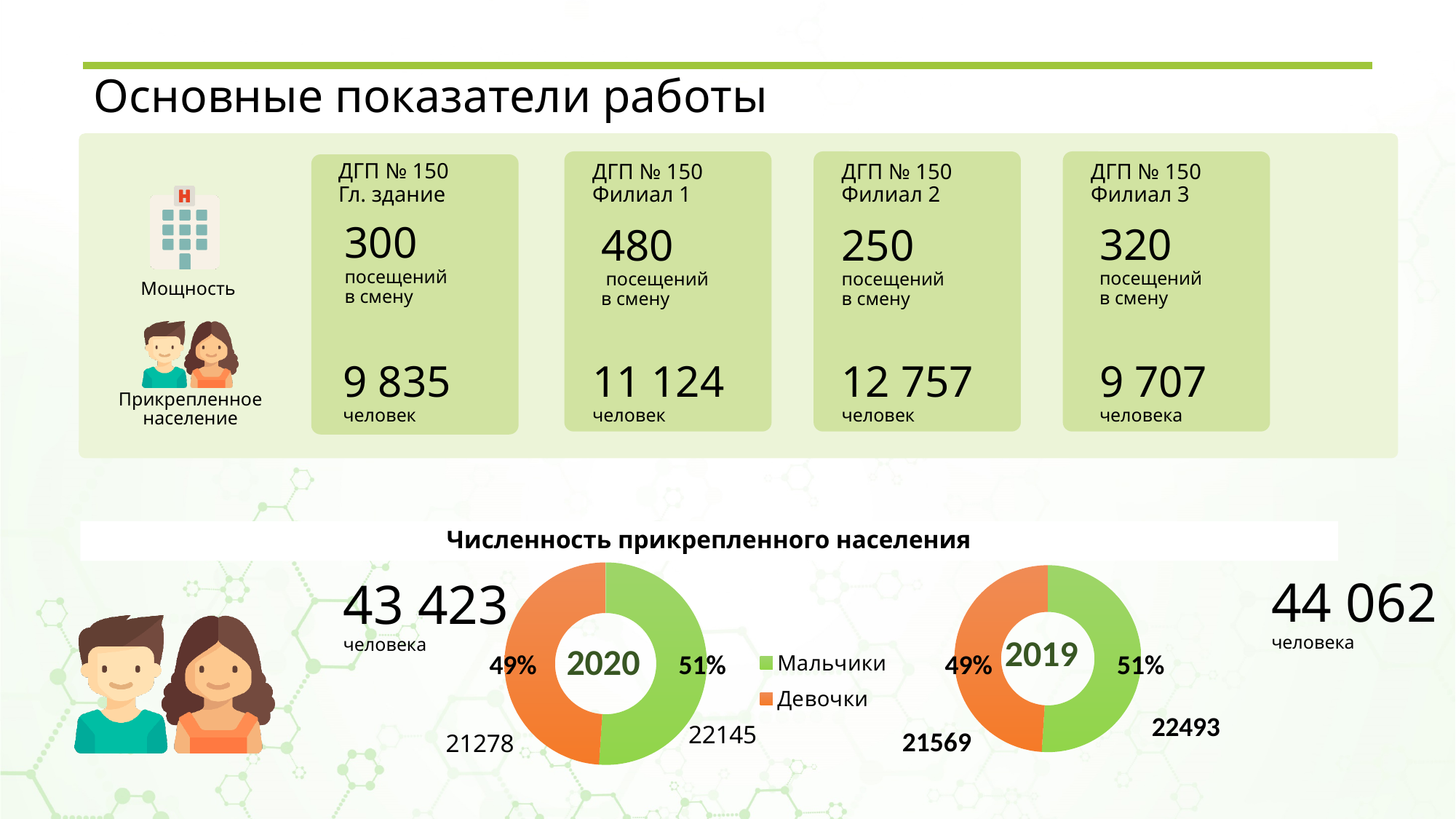
What kind of chart is used to show the 2020 and 2019 population breakdown? Donut (pie) chart In the 2020 donut chart, what is the value for Мальчики? 22145 What is the title of the section containing the two donut charts? Численность прикрепленного населения In the 2019 donut chart, what is the difference between the Мальчики and Девочки values? 924 In the 2019 donut chart, what is the value for Мальчики? 22493 In the 2020 donut chart, what is the difference between the Мальчики and Девочки values? 867 In the 2019 donut chart, what share of the total do Мальчики make up? 51% In the 2020 donut chart, what share of the total do Девочки make up? 49% How many categories does the legend of the donut charts list? 2 In the 2020 donut chart, which category is larger, Мальчики or Девочки? Мальчики In the 2020 donut chart, what is the value for Девочки? 21278 In the 2019 donut chart, what is the value for Девочки? 21569